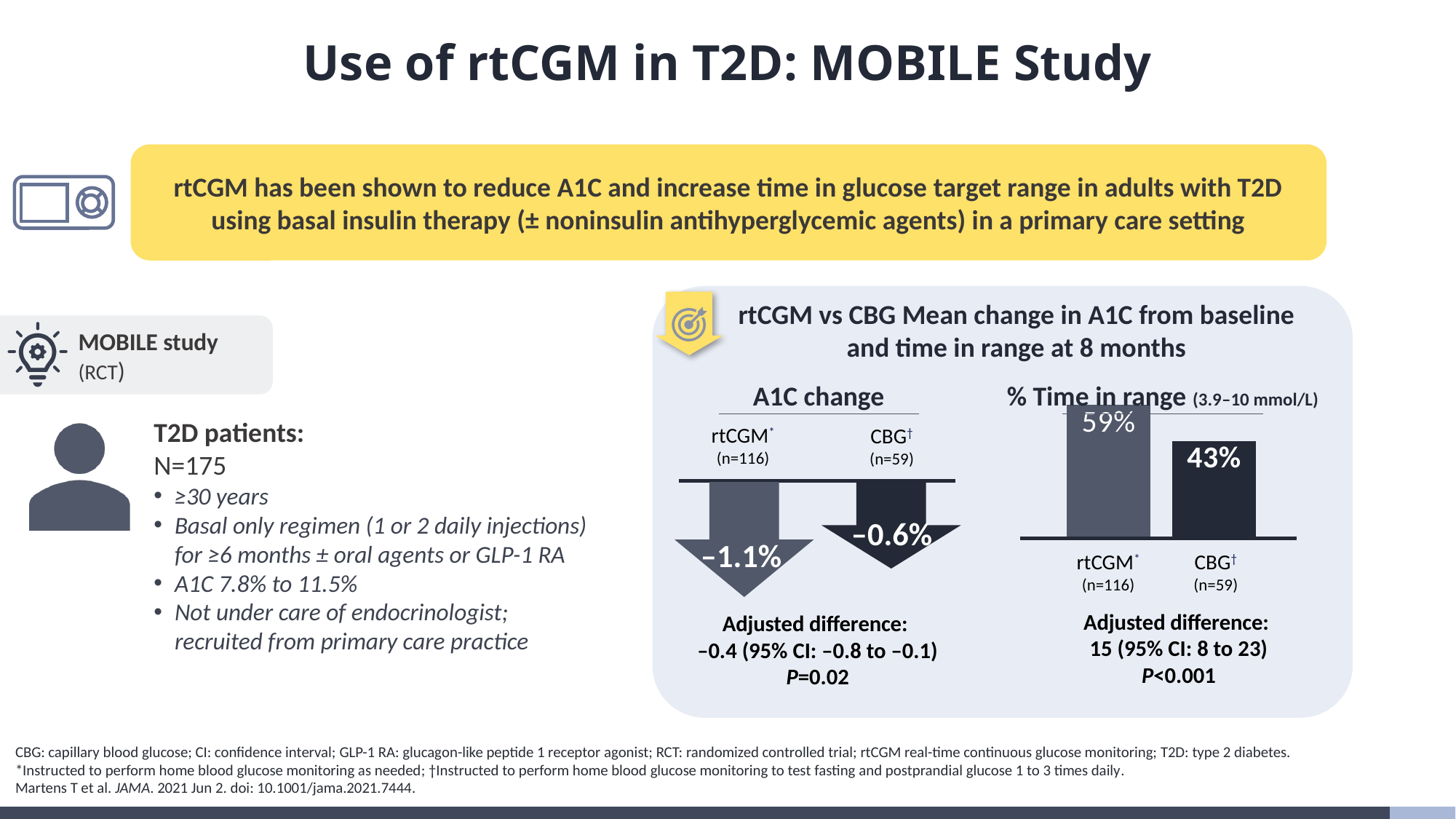
In the A1C change chart, what is the mean change in A1C for rtCGM? –1.1% In the % Time in range chart, what is the value for rtCGM? 59% In the A1C change chart, what is the sample size (n) for the rtCGM group? 116 In the % Time in range chart, what is the sample size (n) for the CBG group? 59 In the A1C change chart, which group shows the larger reduction in A1C? rtCGM In the % Time in range chart, which group has the higher value, rtCGM or CBG? rtCGM In the % Time in range chart, what is the value for CBG? 43% What kind of chart is the % Time in range chart? bar chart What is the adjusted difference reported below the % Time in range chart? 15 (95% CI: 8 to 23) How many groups are shown in the % Time in range chart? 2 What glucose range is used to define time in range in the % Time in range chart? 3.9–10 mmol/L In the A1C change chart, what is the mean change in A1C for CBG? –0.6%